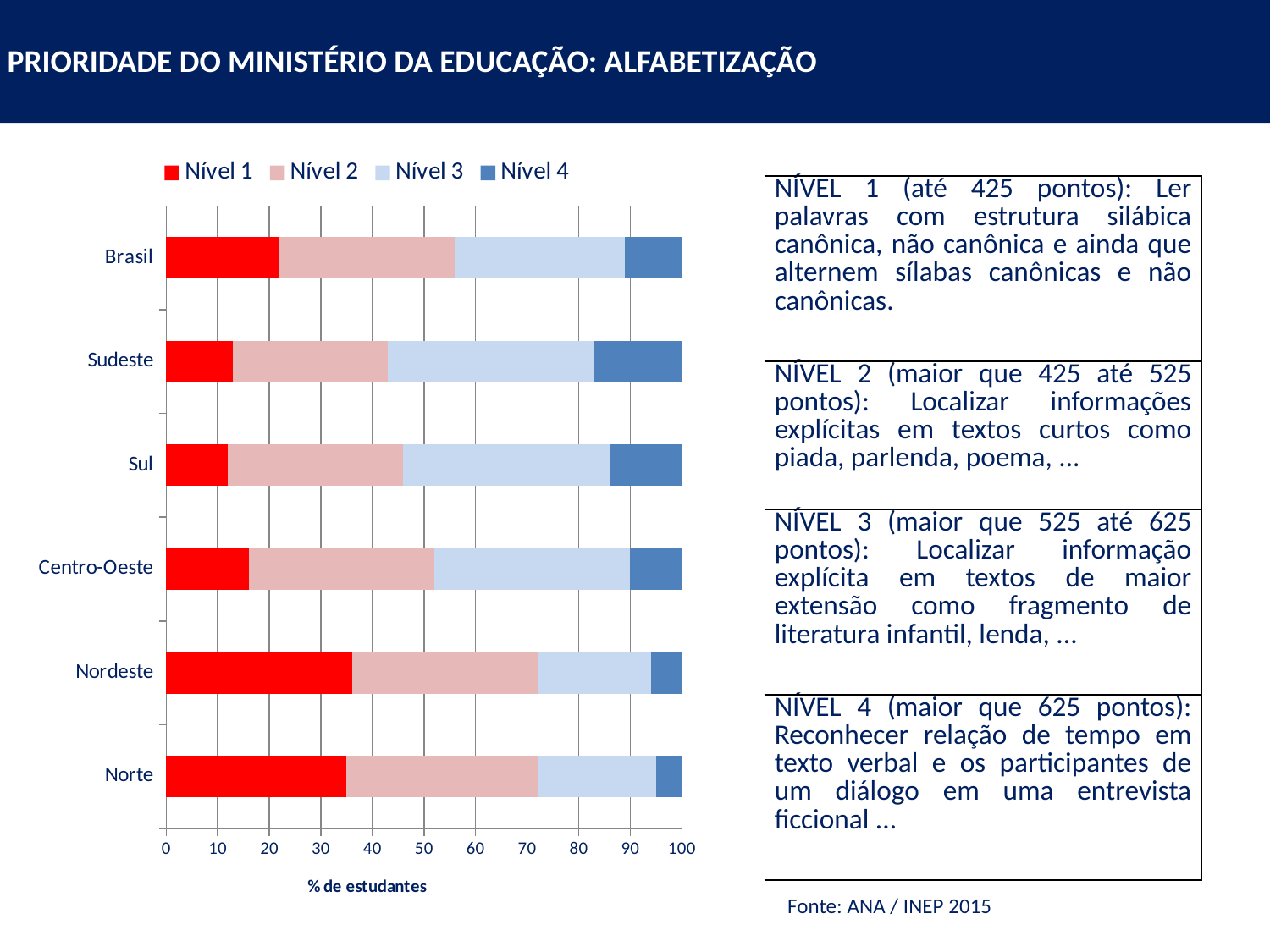
Which has the larger Nível 1 value, Nordeste or Sul? Nordeste Is the Nível 1 value for Sul greater or less than 20? less What is the title of the x axis of the chart? % de estudantes Is the Nível 1 value for Norte greater or less than 30? greater Which has the larger Nível 1 value, Centro-Oeste or Sudeste? Centro-Oeste How many series does the chart legend list? 4 Is the Nível 1 value for Brasil greater or less than 30? less Which has the larger Nível 4 value, Sudeste or Norte? Sudeste What kind of chart is shown on the slide? Stacked bar chart How many categories (regions) are plotted on the y axis of the chart? 6 What are the series names listed in the chart legend? Nível 1, Nível 2, Nível 3, Nível 4